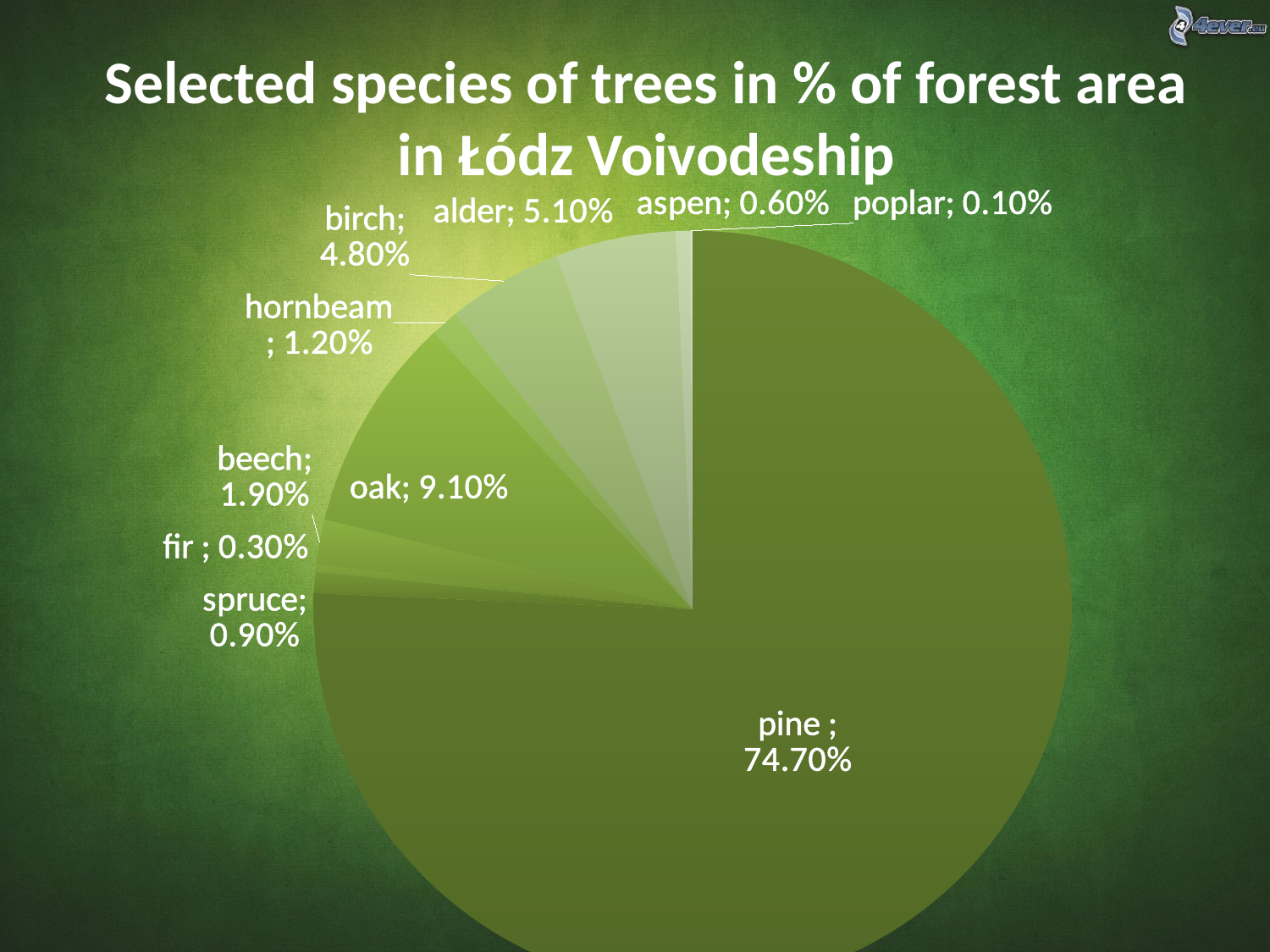
What percentage of forest area is oak? 9.10% What percentage of forest area is pine? 74.70% What is the value shown for alder? 5.10% What is the title of the chart? Selected species of trees in % of forest area in Łódz Voivodeship What is the value shown for hornbeam? 1.20% Which has a larger share, birch or alder? alder Which tree species has the smallest share of forest area? poplar How many tree species are shown in the pie chart? 10 What is the difference between the shares of oak and alder? 4.00% Which tree species has the largest share of forest area? pine What is the difference between the shares of beech and spruce? 1.00% What kind of chart is shown on the slide? pie chart